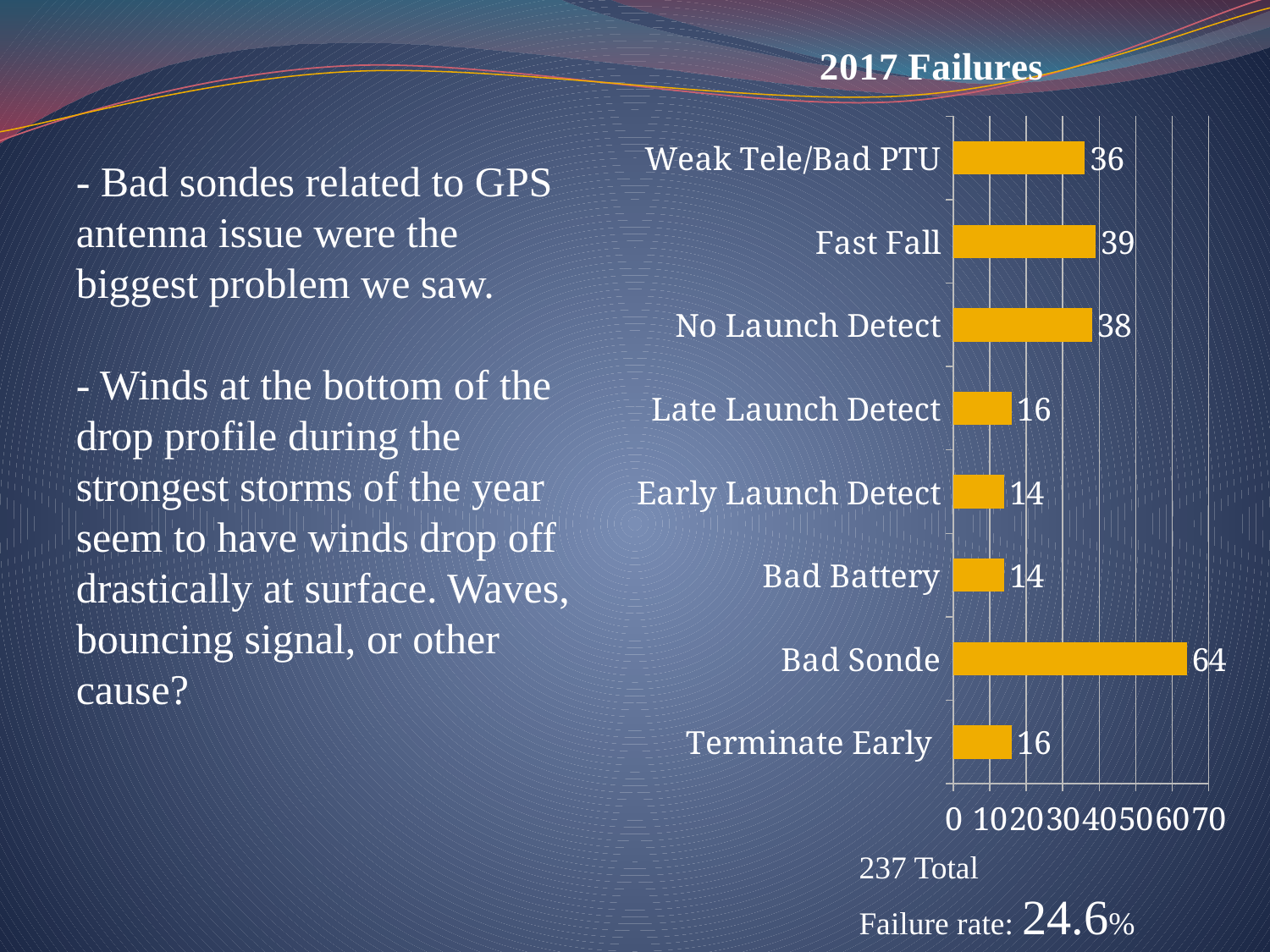
Is the value for Bad Sonde greater or less than 60? greater Which is larger, Fast Fall or No Launch Detect? Fast Fall What is the difference between No Launch Detect and Late Launch Detect? 22 What is the title of the chart? 2017 Failures What is the value for Bad Sonde? 64 What is the value for Weak Tele/Bad PTU? 36 What kind of chart is this? bar chart Which category has the highest value? Bad Sonde What is the difference between Bad Sonde and Fast Fall? 25 Which is larger, Late Launch Detect or Bad Battery? Late Launch Detect How many categories are shown in the chart? 8 What is the value for Fast Fall? 39